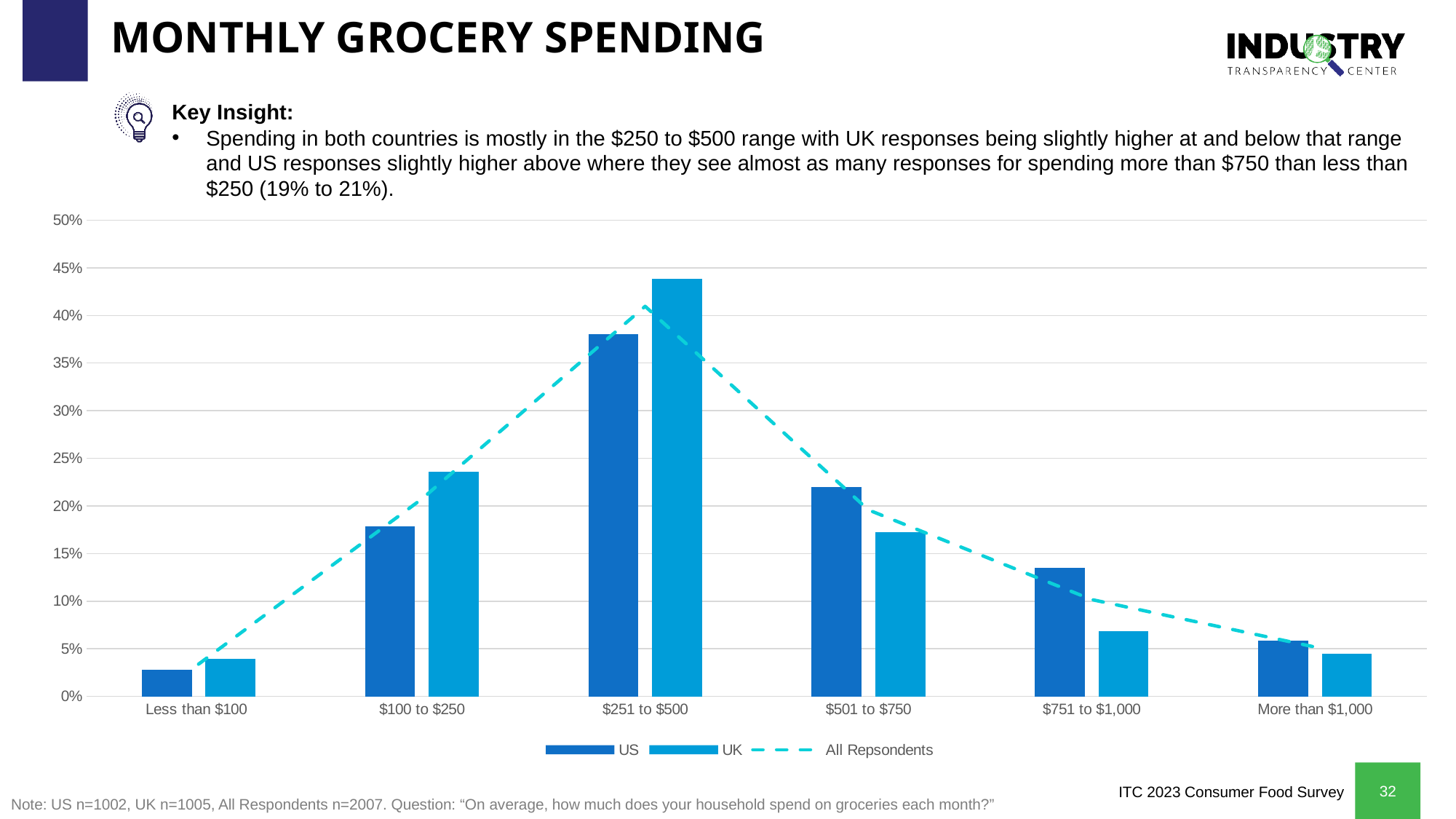
How many series does the legend list? 3 In the $501 to $750 category, which series has the larger value, US or UK? US How many spending categories are shown on the x axis? 6 Which spending category has the highest value for the UK series? $251 to $500 What kind of chart is shown on the slide? bar and line chart What is the title of the slide's chart? MONTHLY GROCERY SPENDING Is the UK value for $251 to $500 greater or less than 40%? greater Which spending category has the highest value for the US series? $251 to $500 Is the US value for $251 to $500 greater or less than 40%? less In the $100 to $250 category, which series has the larger value, US or UK? UK Is the UK value for $751 to $1,000 greater or less than 10%? less Which spending category has the lowest value for the US series? Less than $100